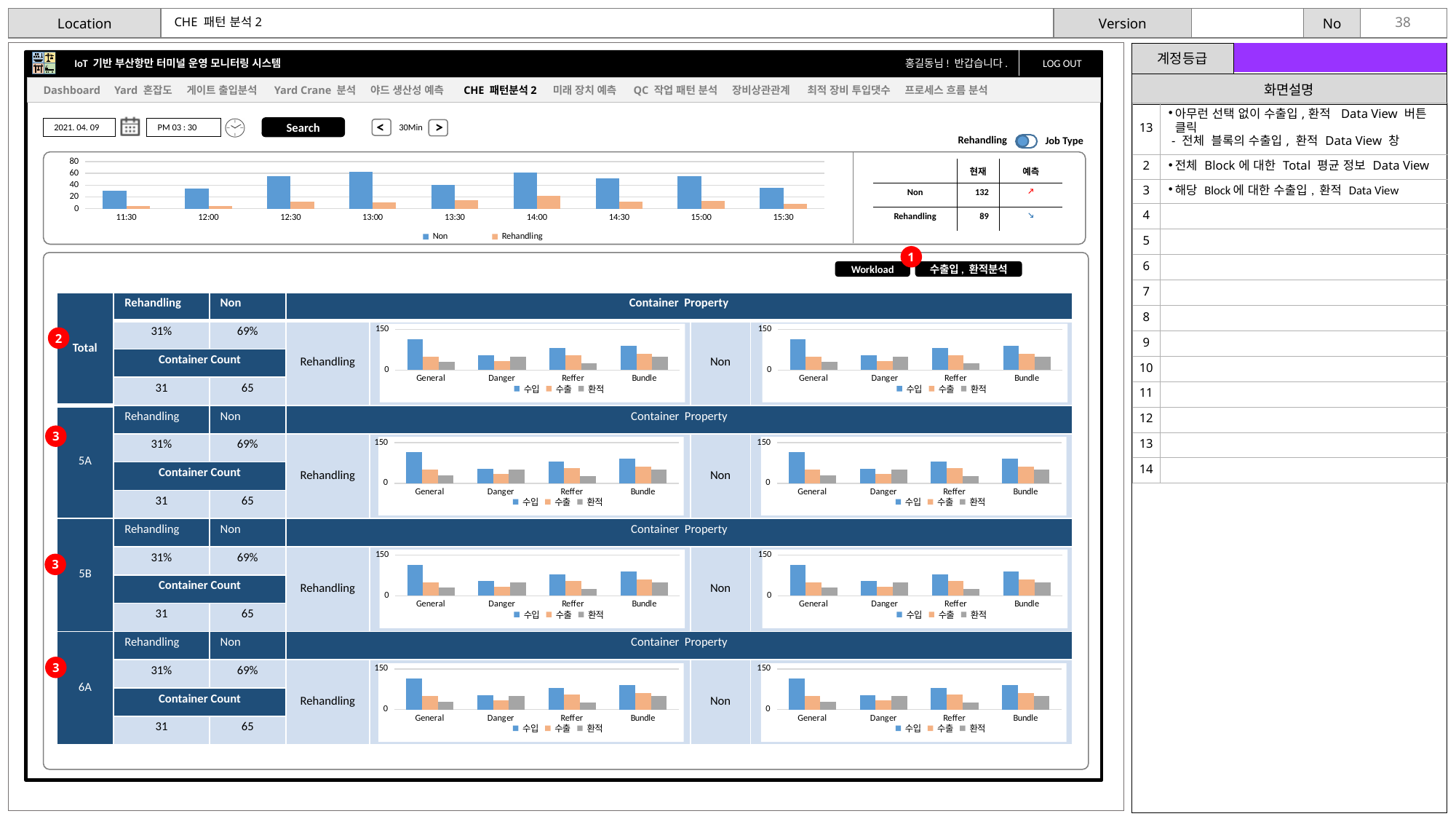
In the top time-series chart, is the Non value at 13:00 greater or less than 40? greater What kind of chart is the top time-series chart showing Non and Rehandling? bar chart In the Total row's Non Container Property chart, how many series does the legend list? 3 In the top time-series chart, at which time is the Rehandling value highest? 14:00 In the Total row's Rehandling Container Property chart, how many categories are on the x axis? 4 In the top time-series chart, how many time points are shown on the x axis? 9 In the top time-series chart, how many series does the legend list? 2 In the top time-series chart, is the Rehandling value at 11:30 greater or less than 20? less In the top time-series chart, what are the two legend entries? Non, Rehandling In the top time-series chart, which is larger for Non, the value at 13:00 or the value at 11:30? 13:00 In the top time-series chart, which is larger at 13:00, Non or Rehandling? Non In the Total row's Rehandling Container Property chart, which category has the tallest bar? General